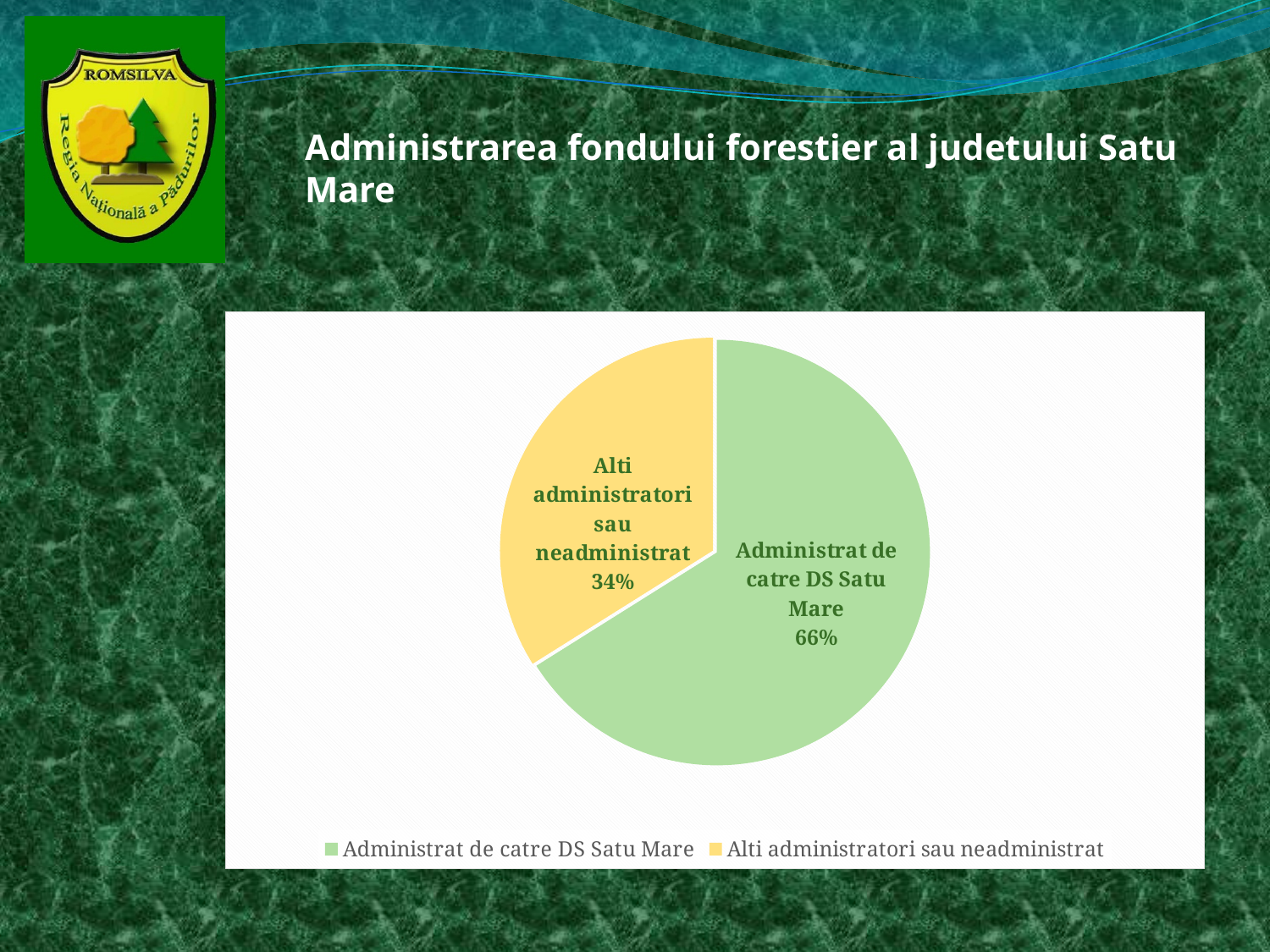
Which slice of the pie chart is the largest? Administrat de catre DS Satu Mare What is the title of the slide containing the pie chart? Administrarea fondului forestier al judetului Satu Mare What share of the pie is labelled "Alti administratori sau neadministrat"? 34% Which slice of the pie chart is the smallest? Alti administratori sau neadministrat How many entries does the chart legend list? 2 Which is larger: the share for "Administrat de catre DS Satu Mare" or the share for "Alti administratori sau neadministrat"? Administrat de catre DS Satu Mare What colour is the "Alti administratori sau neadministrat" slice? Yellow What share of the pie is labelled "Administrat de catre DS Satu Mare"? 66% What kind of chart is shown on the slide? Pie chart What is the difference in percentage points between the "Administrat de catre DS Satu Mare" slice and the "Alti administratori sau neadministrat" slice? 32 percentage points How many slices does the pie chart have? 2